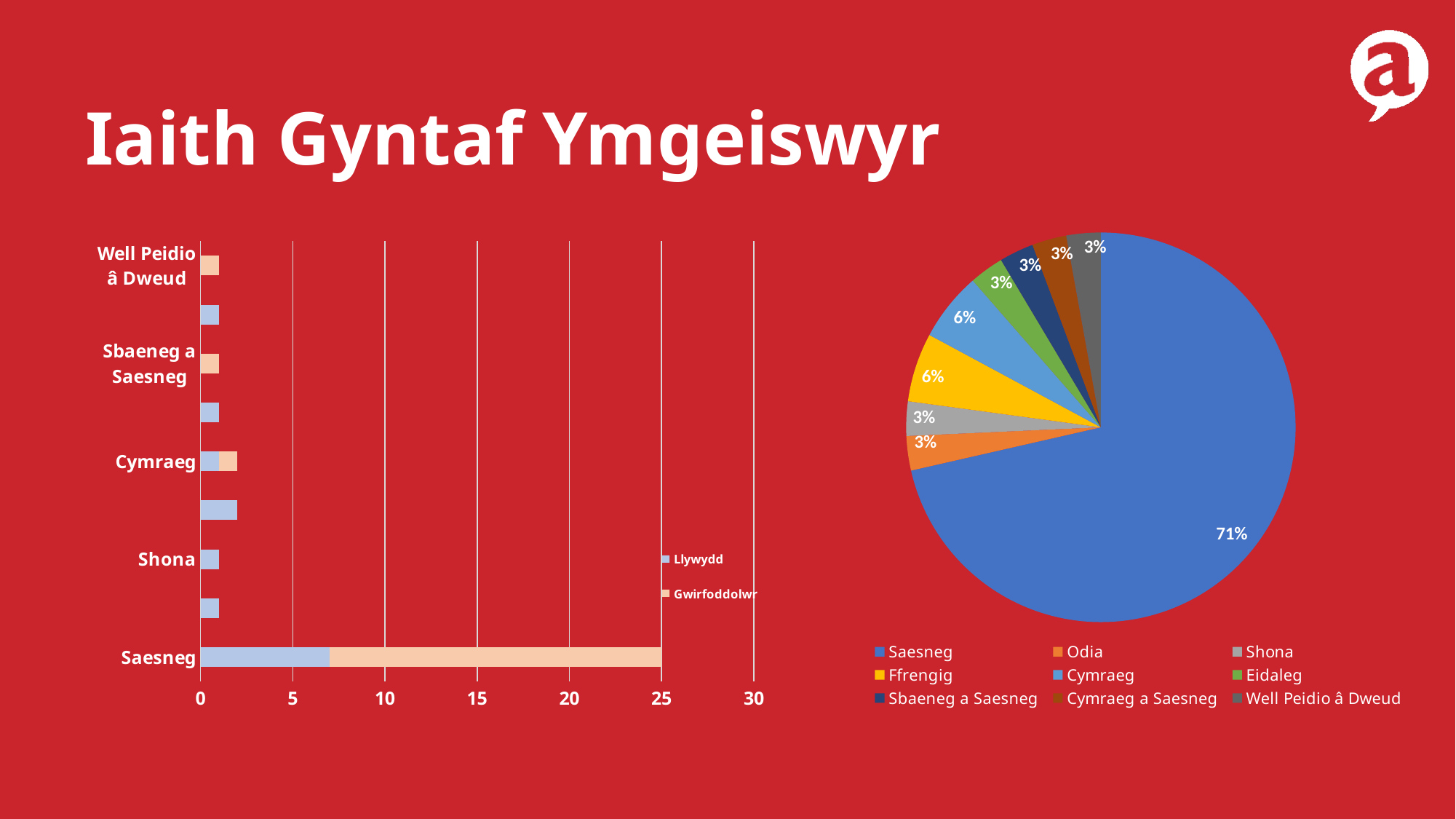
In the pie chart, which is larger, the slice for Ffrengig or the slice for Odia? Ffrengig What kind of chart is the chart on the right of the slide? pie chart In the bar chart, is the total length of the Cymraeg bar greater or less than 5? less What kind of chart is the chart on the left of the slide? bar chart In the pie chart, what share does Ffrengig have? 6% In the pie chart, what is the difference between the share for Saesneg and the share for Ffrengig? 65% In the pie chart, which language has the largest slice? Saesneg In the bar chart, is the total length of the Saesneg bar greater or less than 20? greater In the pie chart, what share does Cymraeg have? 6% How many entries does the legend of the pie chart list? 9 How many series does the legend of the bar chart list? 2 In the pie chart, what share does Saesneg have? 71%